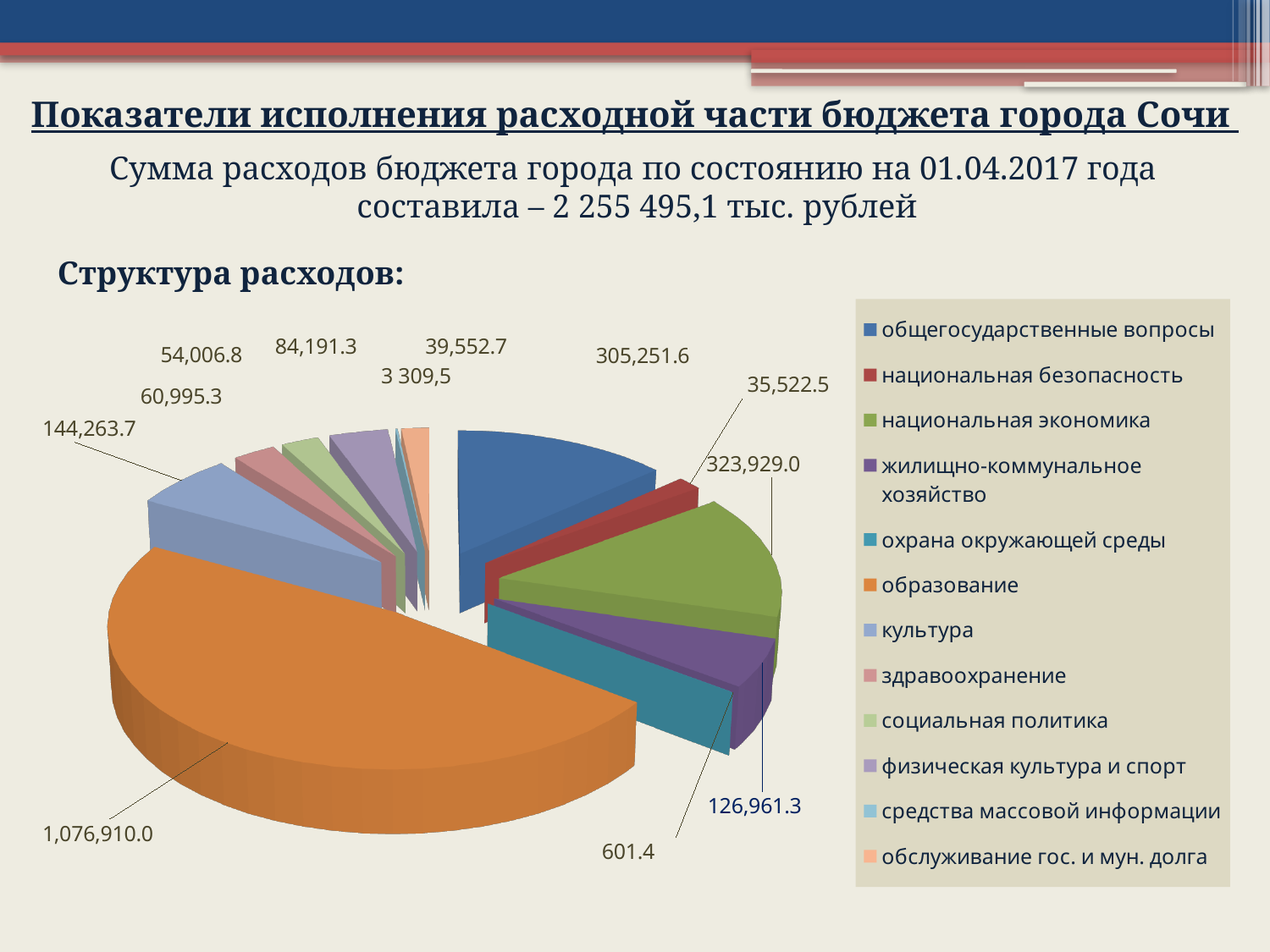
What is the value shown for образование? 1,076,910.0 Which category has the smallest slice of the pie? охрана окружающей среды Which category has the largest slice of the pie? образование What is the value shown for культура? 144,263.7 What is the difference between the values for национальная экономика and общегосударственные вопросы? 18,677.4 What kind of chart is shown on the slide? Pie chart What is the value shown for национальная экономика? 323,929.0 What is the value shown for жилищно-коммунальное хозяйство? 126,961.3 What colour is used for образование in the pie chart? Orange How many categories does the pie chart's legend list? 12 What is the value shown for общегосударственные вопросы? 305,251.6 Which is larger, the value for национальная экономика or the value for общегосударственные вопросы? национальная экономика